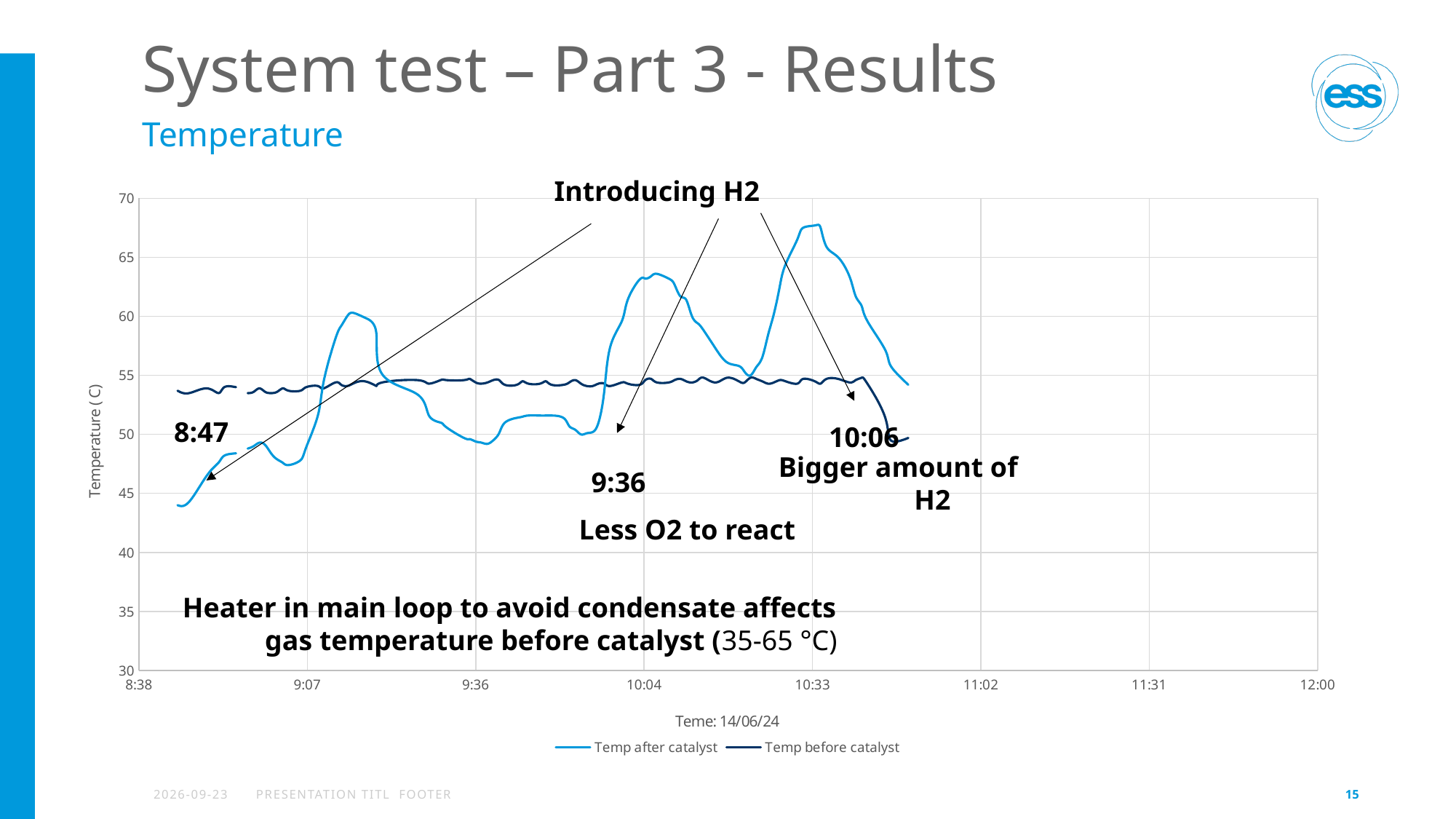
Does Temp before catalyst rise or fall at the end of its recorded data, after about 10:40? fall Is the peak value of Temp after catalyst near 10:04 greater or less than 60? greater What are the two series named in the chart legend? Temp after catalyst and Temp before catalyst Is the value of Temp before catalyst at 9:36 greater or less than 60? less How many time labels are shown on the horizontal axis? 8 Which series reaches the highest temperature on the chart? Temp after catalyst At 10:33, which series has the higher temperature, Temp after catalyst or Temp before catalyst? Temp after catalyst Is the value of Temp after catalyst at the start of the recording (around 8:45) greater or less than 50? less What is the label on the vertical axis of the chart? Temperature (C) What kind of chart is shown on the slide? Line chart How many series does the chart legend list? 2